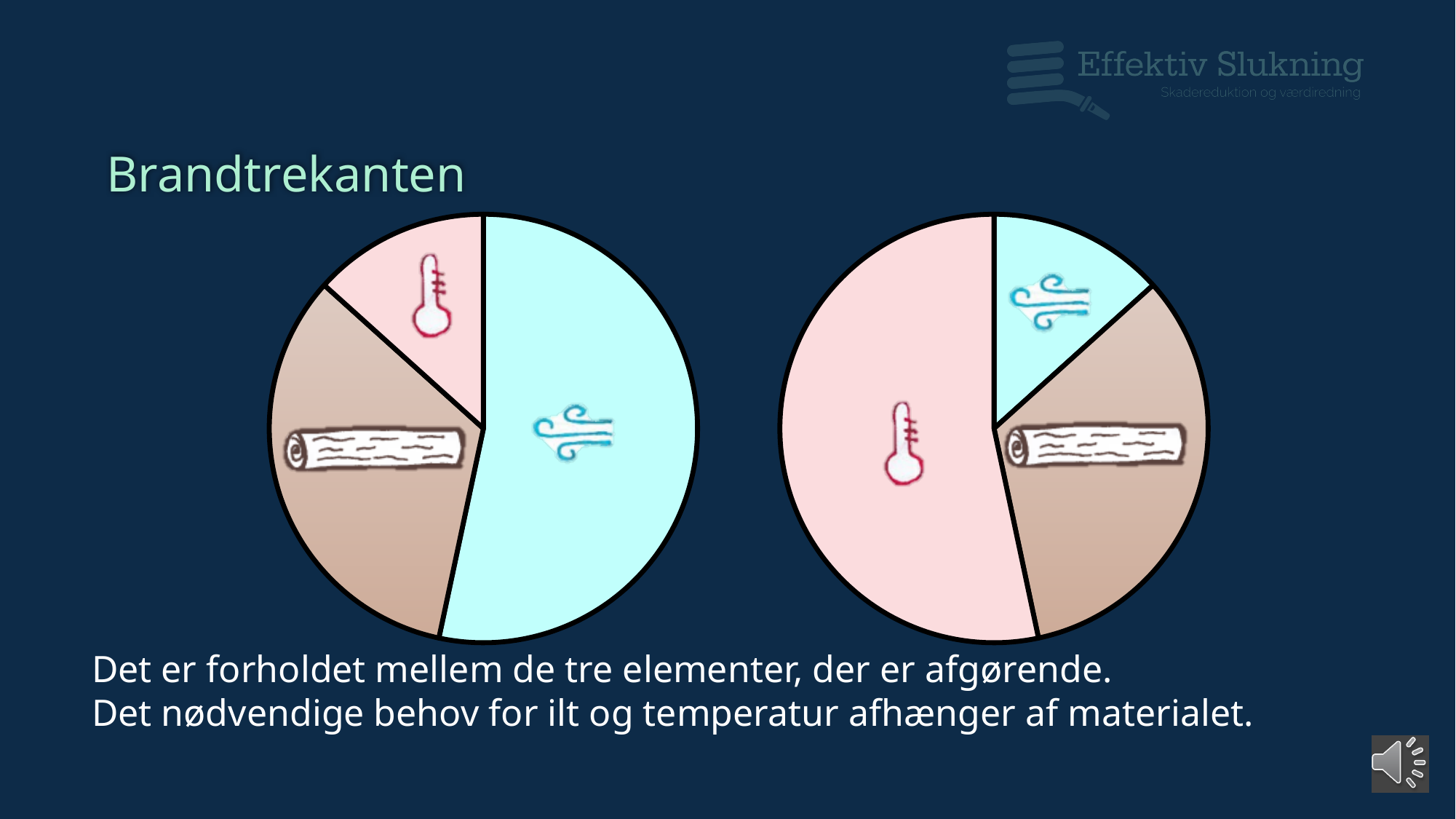
In the right pie chart, which slice is the smallest? the light blue slice with the wind icon In the left pie chart, which slice is the smallest? the pink slice with the thermometer icon In the right pie chart, which slice is the largest? the pink slice with the thermometer icon What kind of chart is the left chart on the slide? pie chart How many slices does the left pie chart have? 3 How many pie charts are shown on the slide? 2 In the left pie chart, which is larger: the slice with the wind icon or the slice with the log icon? the slice with the wind icon How many slices does the right pie chart have? 3 In the right pie chart, which is larger: the slice with the log icon or the slice with the wind icon? the slice with the log icon In the left pie chart, is the slice with the wind icon greater or less than half of the pie? greater In the left pie chart, which slice is the largest? the light blue slice with the wind icon What is the title shown above the charts on the slide? Brandtrekanten